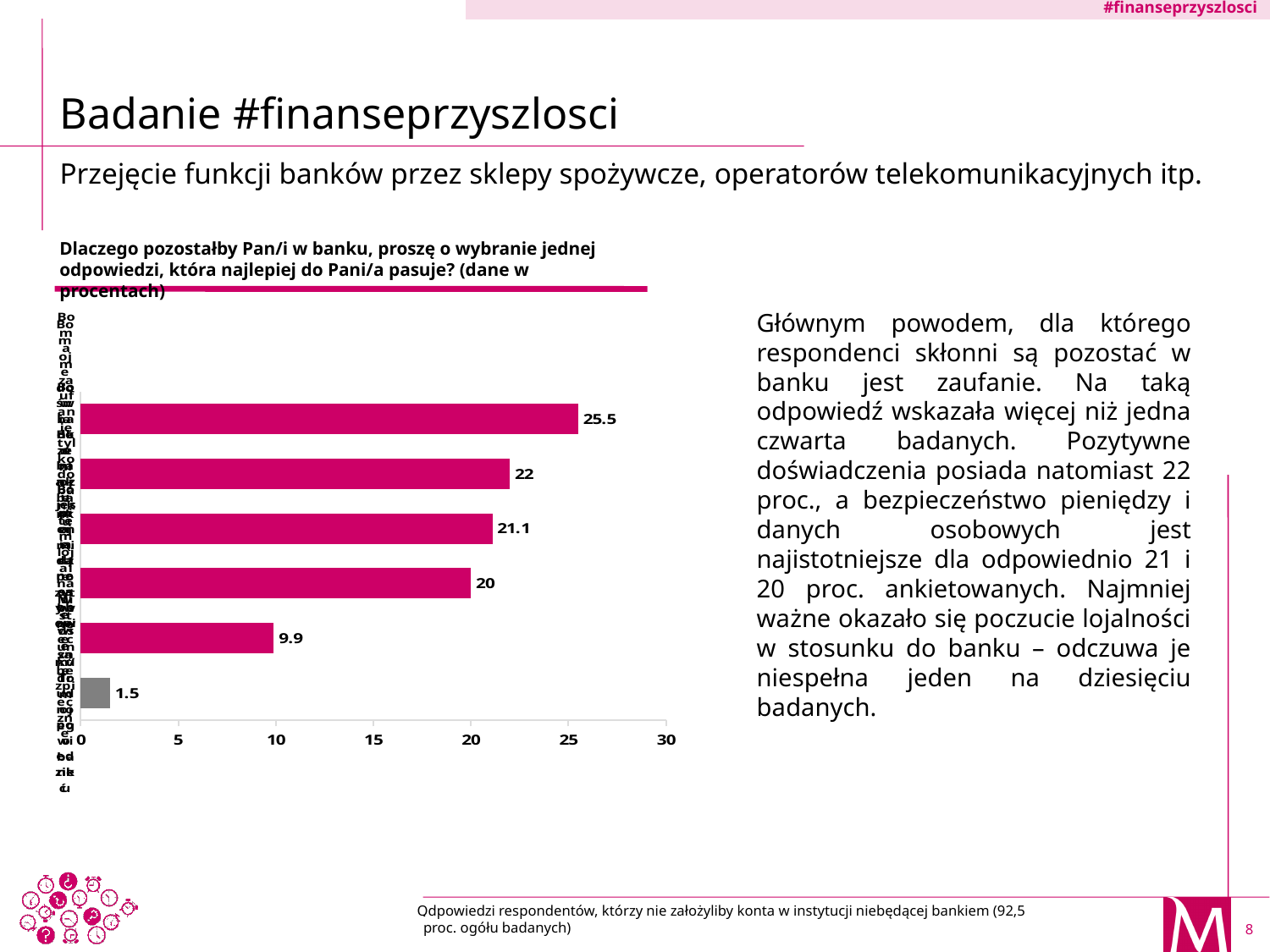
What is the highest value shown in the chart? 25.5 What is the lowest value shown in the chart? 1.5 Which is larger: the third bar from the top (21.1) or the fourth bar from the top (20)? 21.1 What is the value of the topmost bar in the chart? 25.5 What is the difference between the top bar (25.5) and the second bar (22)? 3.5 Is the value of the fifth bar from the top greater or less than 10? less What is the value of the second bar from the top? 22 What colour is the bottom bar in the chart, which differs from the other bars? grey How many bars does the chart contain? 6 What is the value of the fifth bar from the top? 9.9 What is the value of the bottom bar in the chart? 1.5 What kind of chart is shown on the slide? bar chart